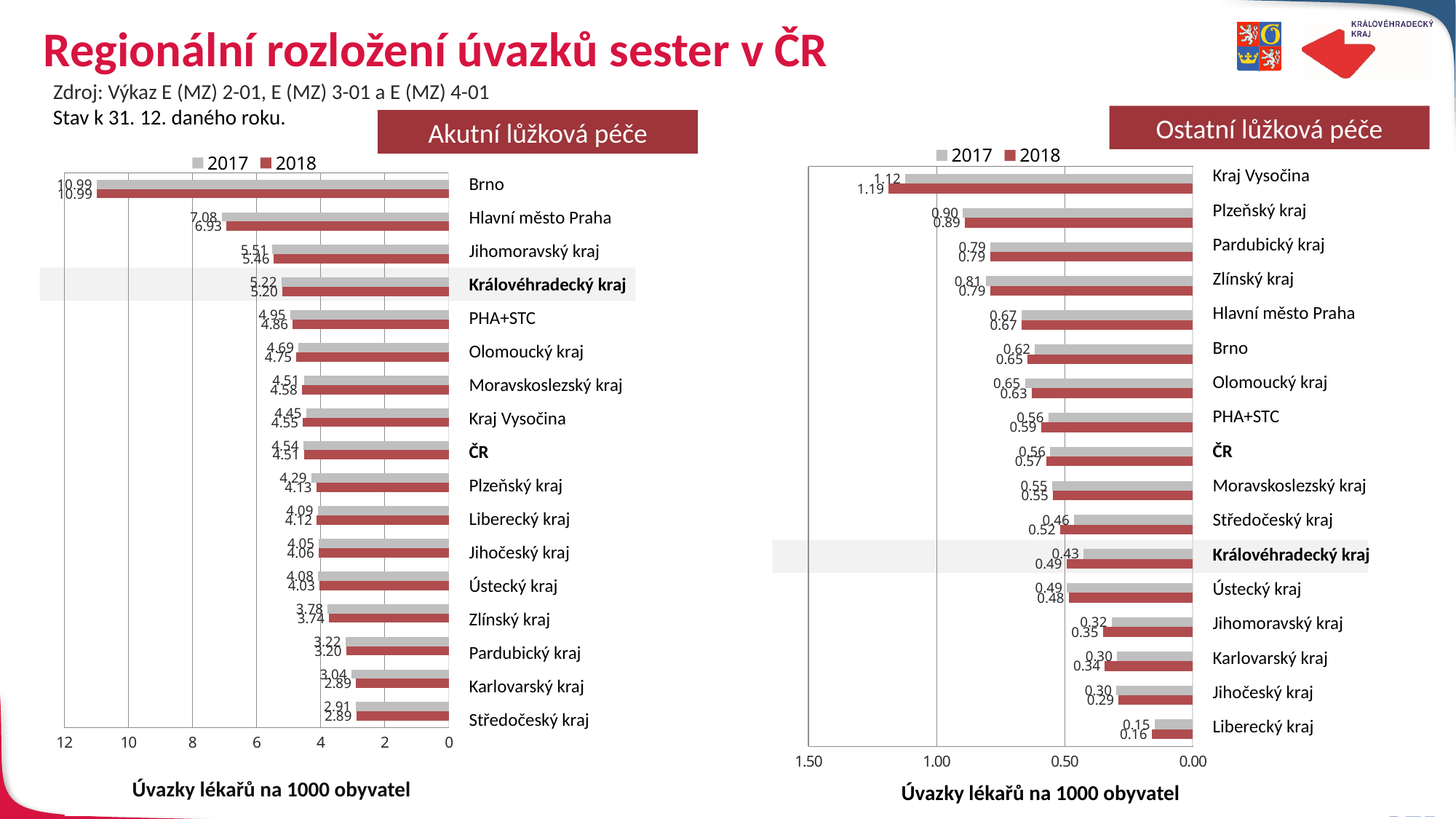
In the 'Akutní lůžková péče' chart, what is the 2018 value for Královéhradecký kraj? 5.20 In the 'Ostatní lůžková péče' chart, what is the 2017 value for Královéhradecký kraj? 0.43 In the 'Akutní lůžková péče' chart, what is the 2017 value for Hlavní město Praha? 7.08 In the 'Ostatní lůžková péče' chart, which category has the lowest 2018 value? Liberecký kraj What type of chart is the 'Akutní lůžková péče' chart? Bar chart In the 'Akutní lůžková péče' chart, how many categories are shown? 17 In the 'Akutní lůžková péče' chart, what is the difference between the 2017 and 2018 values for Karlovarský kraj? 0.15 In the 'Akutní lůžková péče' chart, which category has the highest 2018 value? Brno In the 'Ostatní lůžková péče' chart, is the 2018 value for Plzeňský kraj larger or the 2018 value for Pardubický kraj? Plzeňský kraj How many series does the legend of the 'Ostatní lůžková péče' chart list? 2 In the 'Ostatní lůžková péče' chart, what is the 2018 value for Kraj Vysočina? 1.19 In the 'Akutní lůžková péče' chart, which category has the lowest 2017 value? Středočeský kraj